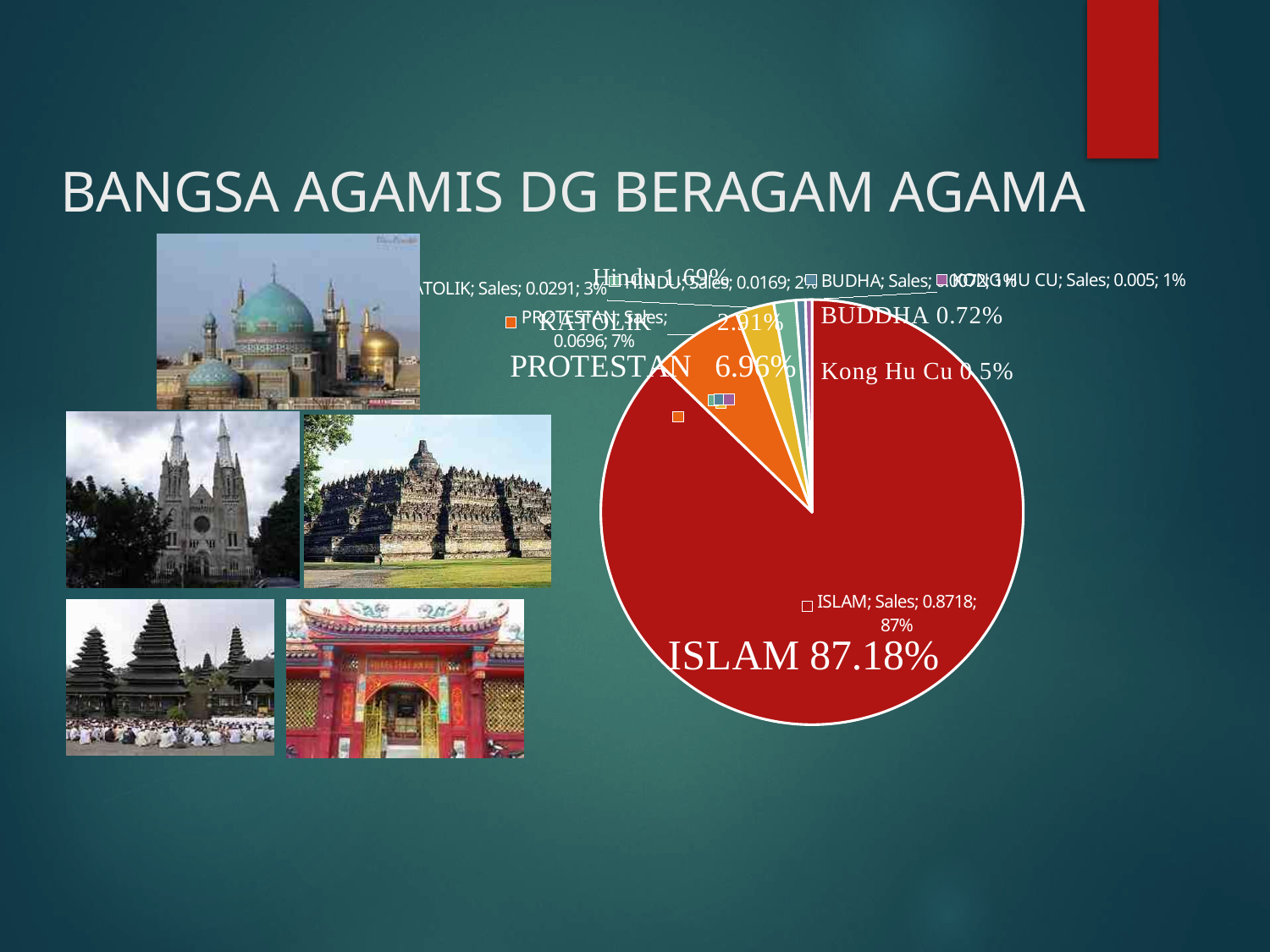
What kind of chart is shown on the slide? pie chart What Sales value is printed in the data label for PROTESTAN? 0.0696 What Sales value is printed in the data label for ISLAM? 0.8718 Which slice is larger, PROTESTAN or KATOLIK? PROTESTAN According to the large text label on the chart, what share does BUDDHA have? 0.72% Using the large text labels, what is the difference in percentage points between ISLAM (87.18%) and PROTESTAN (6.96%)? 80.22 Which religion has the largest slice of the pie chart? ISLAM How many slices (categories) does the pie chart have? 6 According to the large text label on the chart, what share does PROTESTAN have? 6.96% Which religion has the smallest slice of the pie chart? Kong Hu Cu According to the large text label on the chart, what share does ISLAM have? 87.18% What Sales value is printed in the data label for KONG HU CU? 0.005